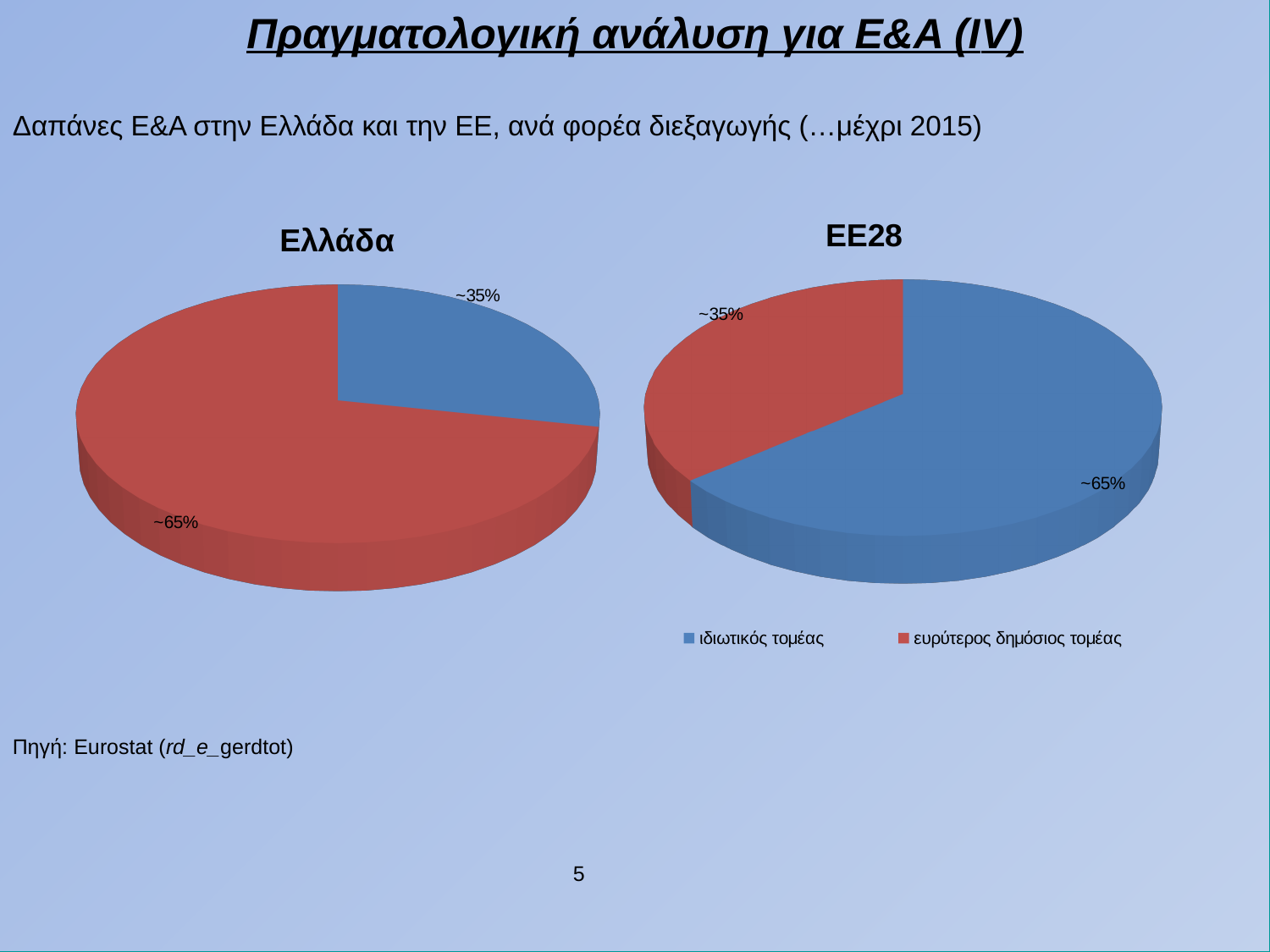
In the "ΕΕ28" chart, which is larger: ιδιωτικός τομέας or ευρύτερος δημόσιος τομέας? ιδιωτικός τομέας What is the title of the pie chart on the left of the slide? Ελλάδα In the "Ελλάδα" chart, which sector has the smallest slice? ιδιωτικός τομέας How many slices does the "Ελλάδα" pie chart have? 2 What colour represents ιδιωτικός τομέας in the pie charts? blue How many entries does the legend list for the pie charts? 2 What kind of chart is the chart titled "Ελλάδα"? pie chart In the "Ελλάδα" chart, which sector has the largest slice? ευρύτερος δημόσιος τομέας In the "ΕΕ28" chart, which sector has the smallest slice? ευρύτερος δημόσιος τομέας In the "Ελλάδα" chart, which is larger: ιδιωτικός τομέας or ευρύτερος δημόσιος τομέας? ευρύτερος δημόσιος τομέας What kind of chart is the chart titled "ΕΕ28"? pie chart In the "ΕΕ28" chart, which sector has the largest slice? ιδιωτικός τομέας